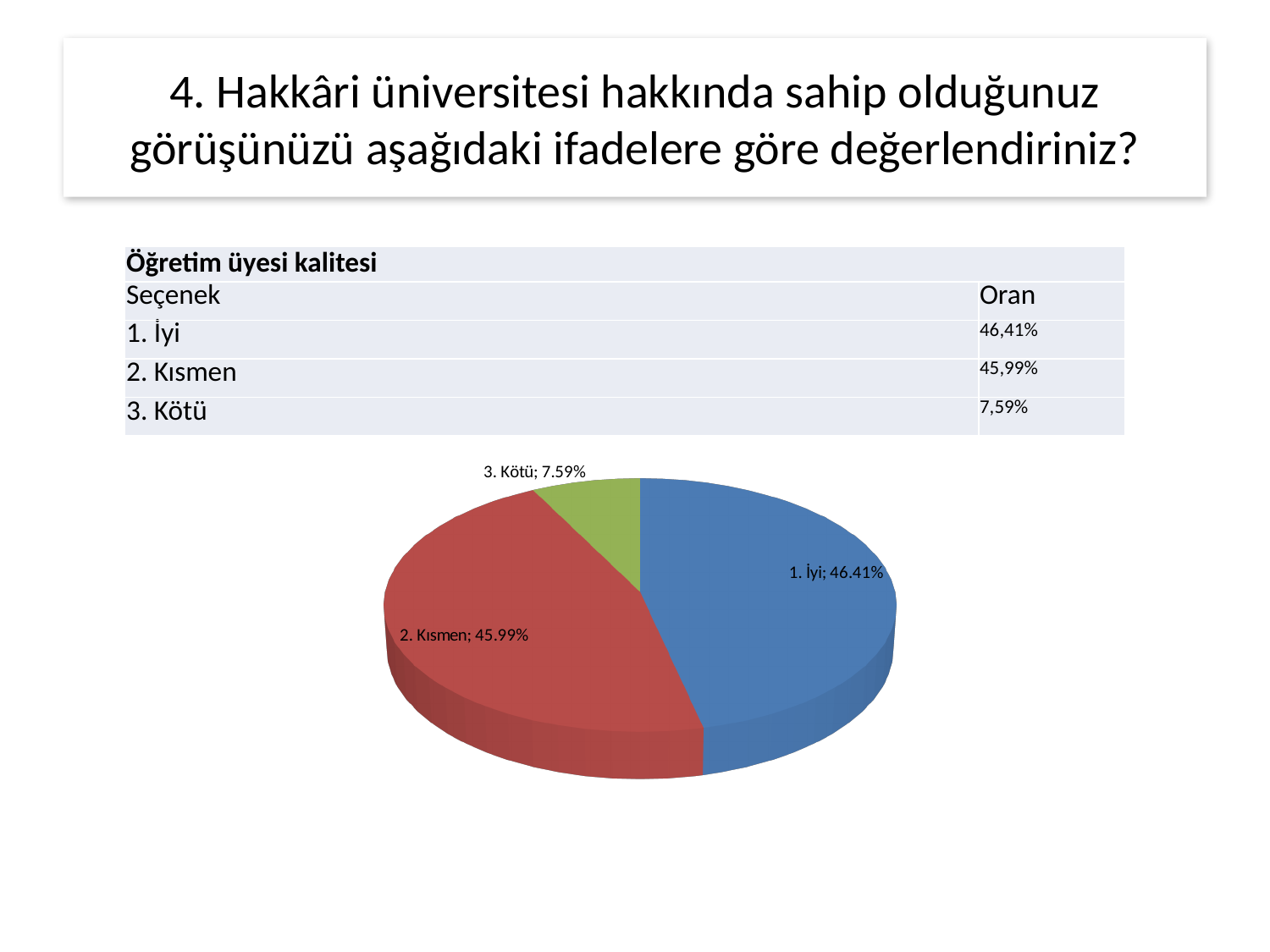
Which slice is larger in the pie chart, 2. Kısmen or 3. Kötü? 2. Kısmen What share of the pie does the 3. Kötü slice represent? 7.59% Which slice is larger in the pie chart, 1. İyi or 3. Kötü? 1. İyi What kind of chart is shown on the slide? pie chart Which category has the smallest slice in the pie chart? 3. Kötü What percentage does the pie chart show for 2. Kısmen? 45.99% What percentage does the pie chart show for 1. İyi? 46.41% What is the difference between the 1. İyi and 3. Kötü percentages in the pie chart? 38.82% What colour is the 1. İyi slice in the pie chart? blue What percentage does the pie chart show for 3. Kötü? 7.59% What is the difference between the 2. Kısmen and 3. Kötü percentages in the pie chart? 38.40% How many slices does the pie chart have? 3